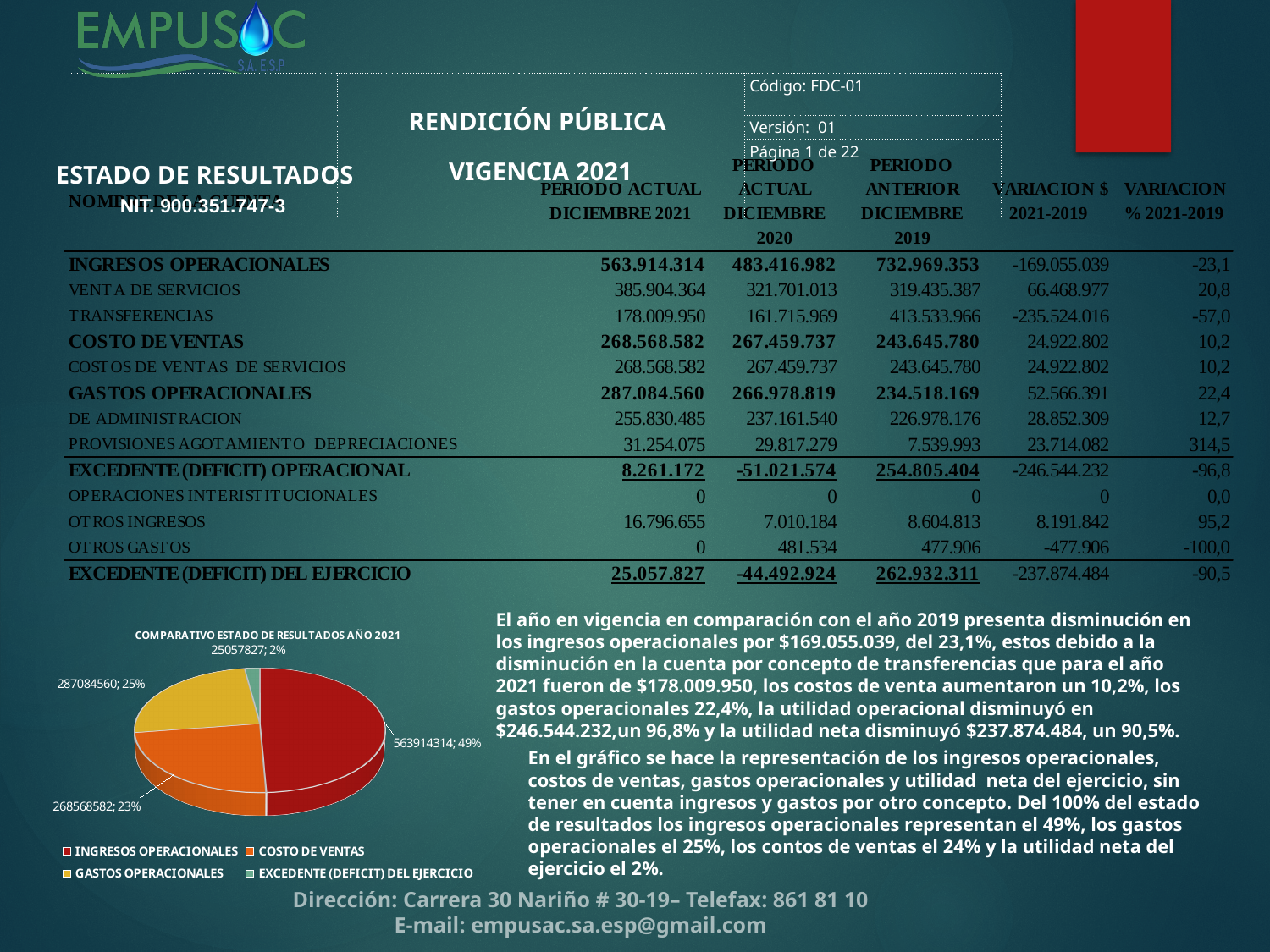
How many entries does the chart legend list? 4 What is the title of the chart on the slide? COMPARATIVO ESTADO DE RESULTADOS AÑO 2021 How many slices does the pie chart have? 4 Which is larger in the pie chart, GASTOS OPERACIONALES or COSTO DE VENTAS? GASTOS OPERACIONALES Which slice of the pie chart is the largest? INGRESOS OPERACIONALES What share of the pie does INGRESOS OPERACIONALES represent? 49% What value is labelled on the INGRESOS OPERACIONALES slice? 563914314 What share of the pie does EXCEDENTE (DEFICIT) DEL EJERCICIO represent? 2% What share of the pie does COSTO DE VENTAS represent? 23% What kind of chart is shown on the slide? pie chart Which slice of the pie chart is the smallest? EXCEDENTE (DEFICIT) DEL EJERCICIO